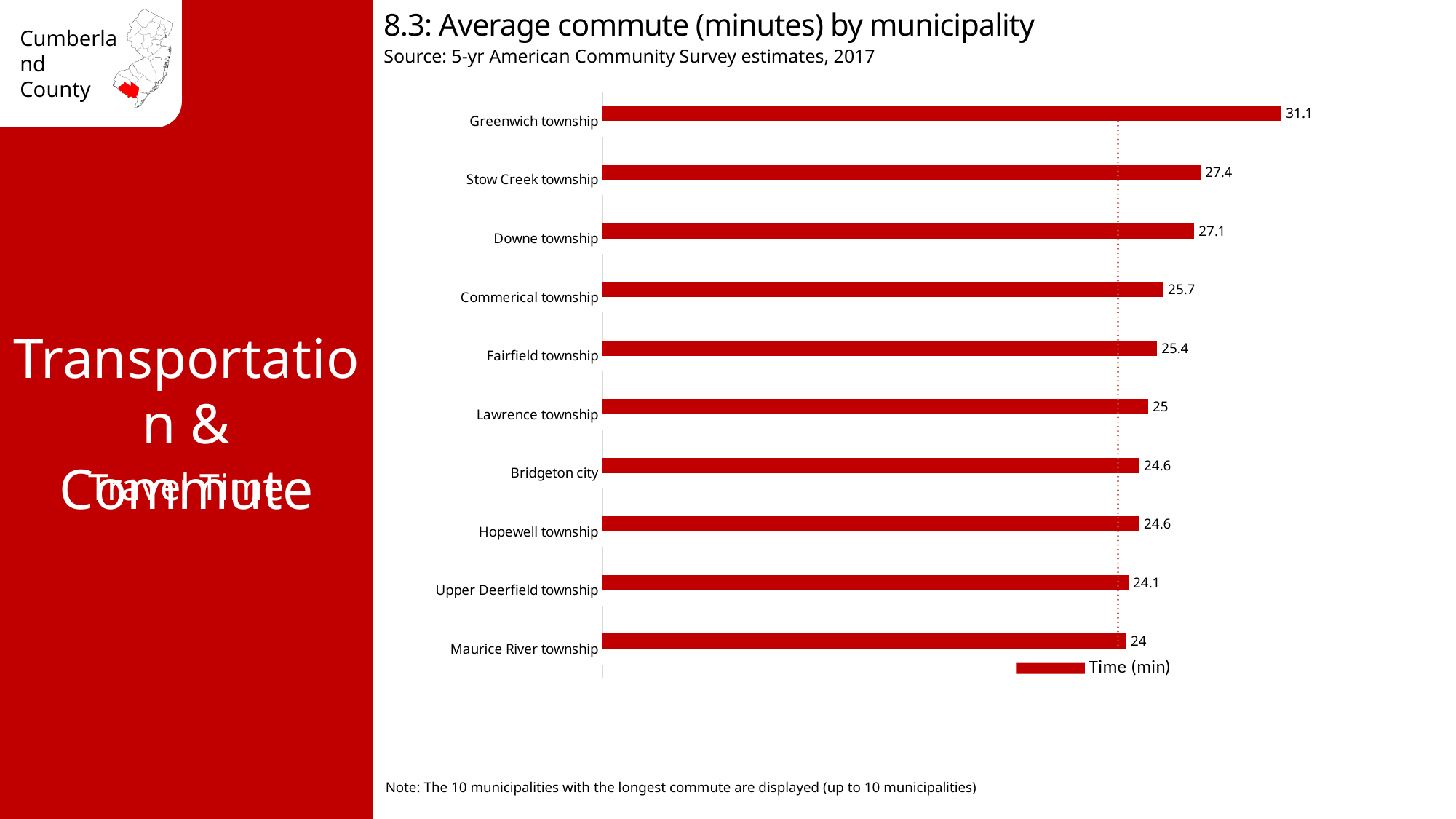
What is the difference in average commute time between Commerical township and Maurice River township? 1.7 What is the difference in average commute time between Greenwich township and Stow Creek township? 3.7 How many municipalities are shown on the chart? 10 What is the legend entry for the series on the chart? Time (min) Which municipality has the longest average commute? Greenwich township What is the average commute time for Upper Deerfield township? 24.1 What is the average commute time for Lawrence township? 25 What kind of chart is shown on the slide? Bar chart Which has a longer average commute, Downe township or Fairfield township? Downe township How many series does the legend list? 1 What is the average commute time for Greenwich township? 31.1 Which municipality has the shortest average commute shown on the chart? Maurice River township